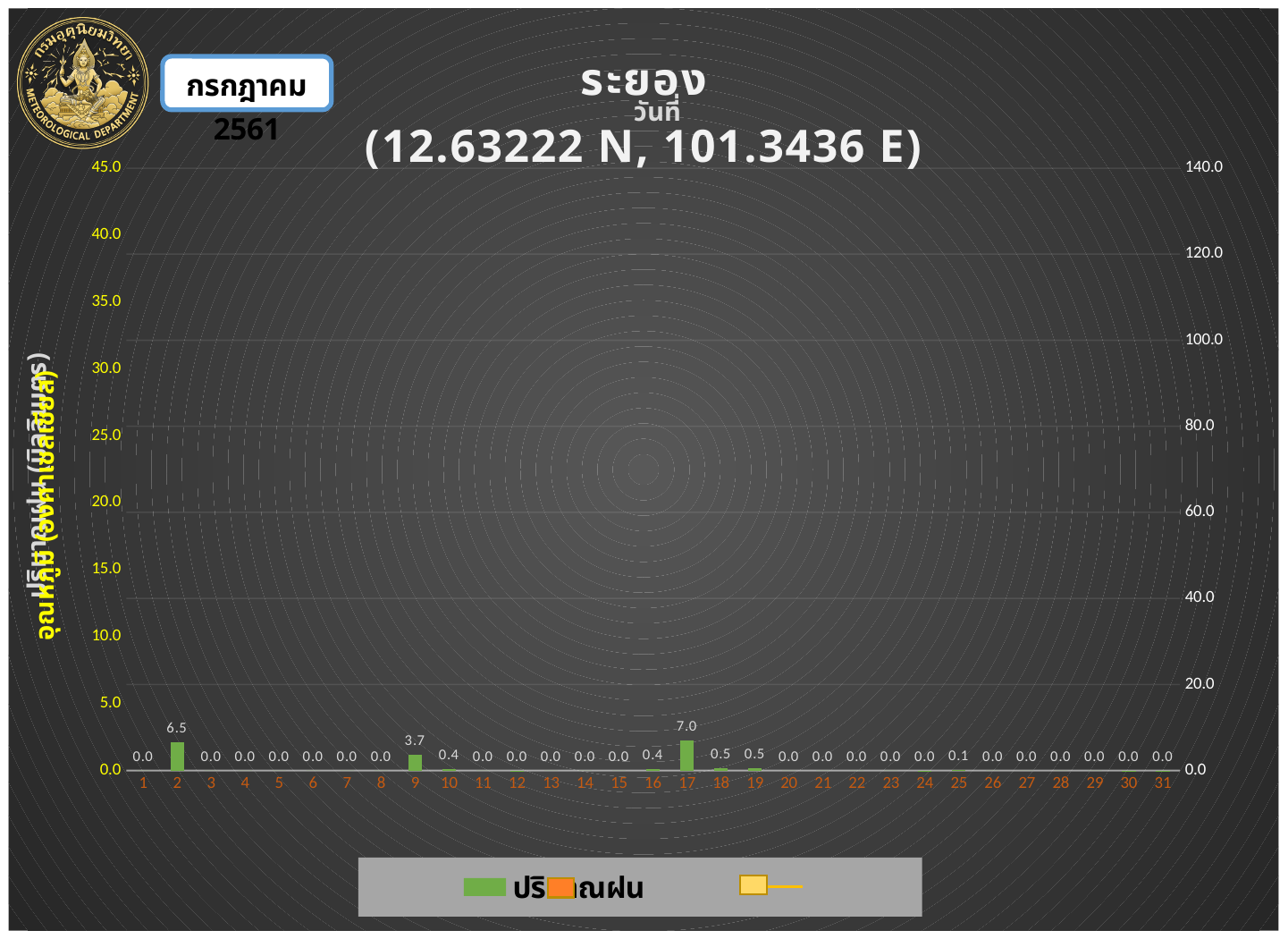
What is the value shown for day 17? 7.0 Which day has the highest value? 17 What is the value shown for day 18? 0.5 What is the value shown for day 2? 6.5 What is the difference between the values for day 17 and day 2? 0.5 What is the highest tick value on the left vertical axis? 45.0 How many days are shown on the x axis? 31 Is the value for day 17 greater or less than 5.0 on the left axis? greater What is the value shown for day 25? 0.1 Which is larger, the value for day 2 or the value for day 9? day 2 What is the value shown for day 9? 3.7 What kind of chart is this? bar chart